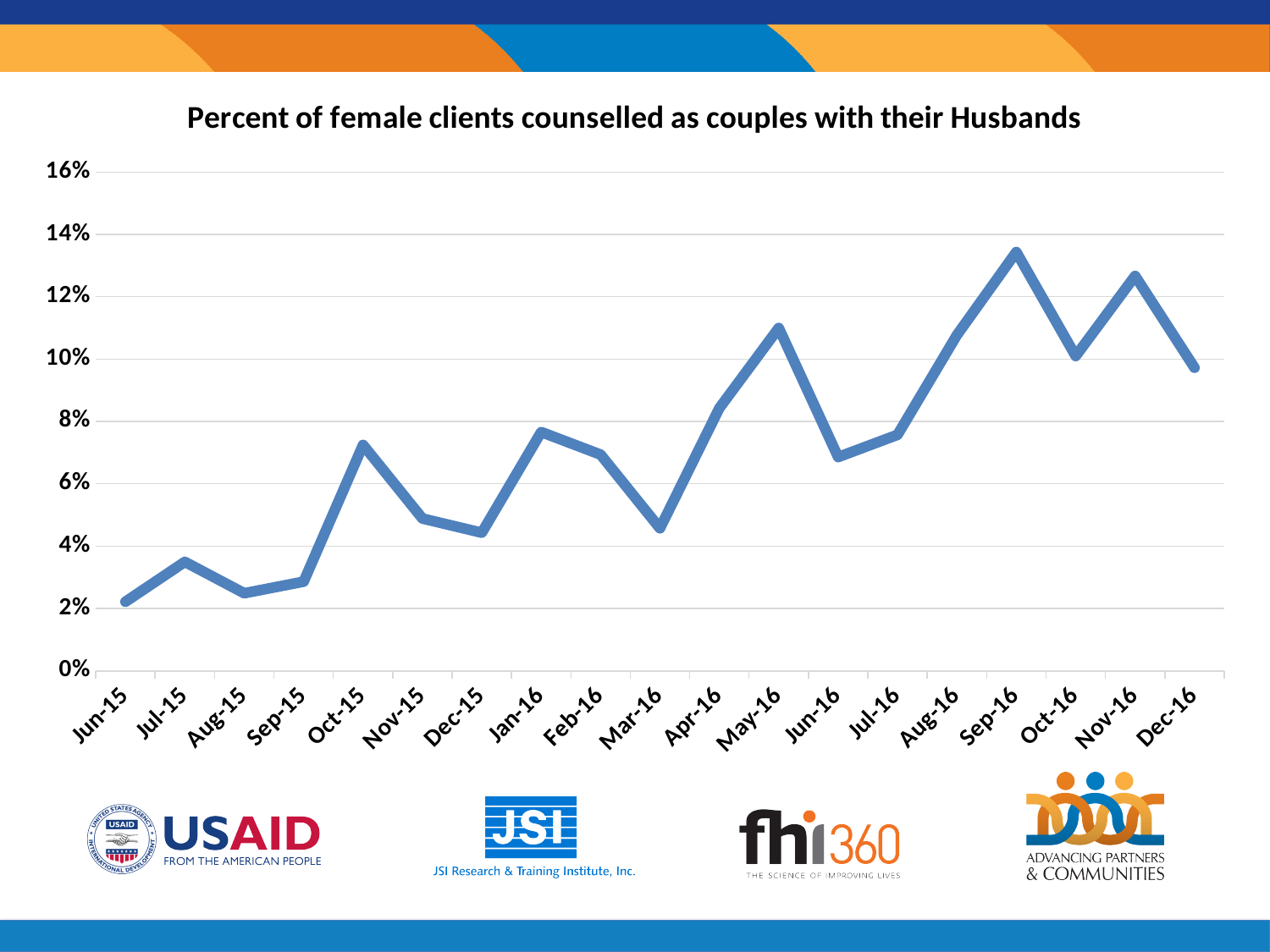
Is the value for Mar-16 greater or less than 6%? less What is the title of the chart? Percent of female clients counselled as couples with their Husbands What kind of chart is shown on the slide? line chart Is the value for Sep-16 greater or less than 12%? greater Which month has the highest percent of female clients counselled as couples? Sep-16 Which is larger, the value for May-16 or the value for Jun-16? May-16 Is the value for Jun-15 greater or less than 4%? less How many months are plotted along the x axis? 19 Overall, do the values rise or fall from Jun-15 to Dec-16? rise Which is larger, the value for Sep-16 or the value for Oct-16? Sep-16